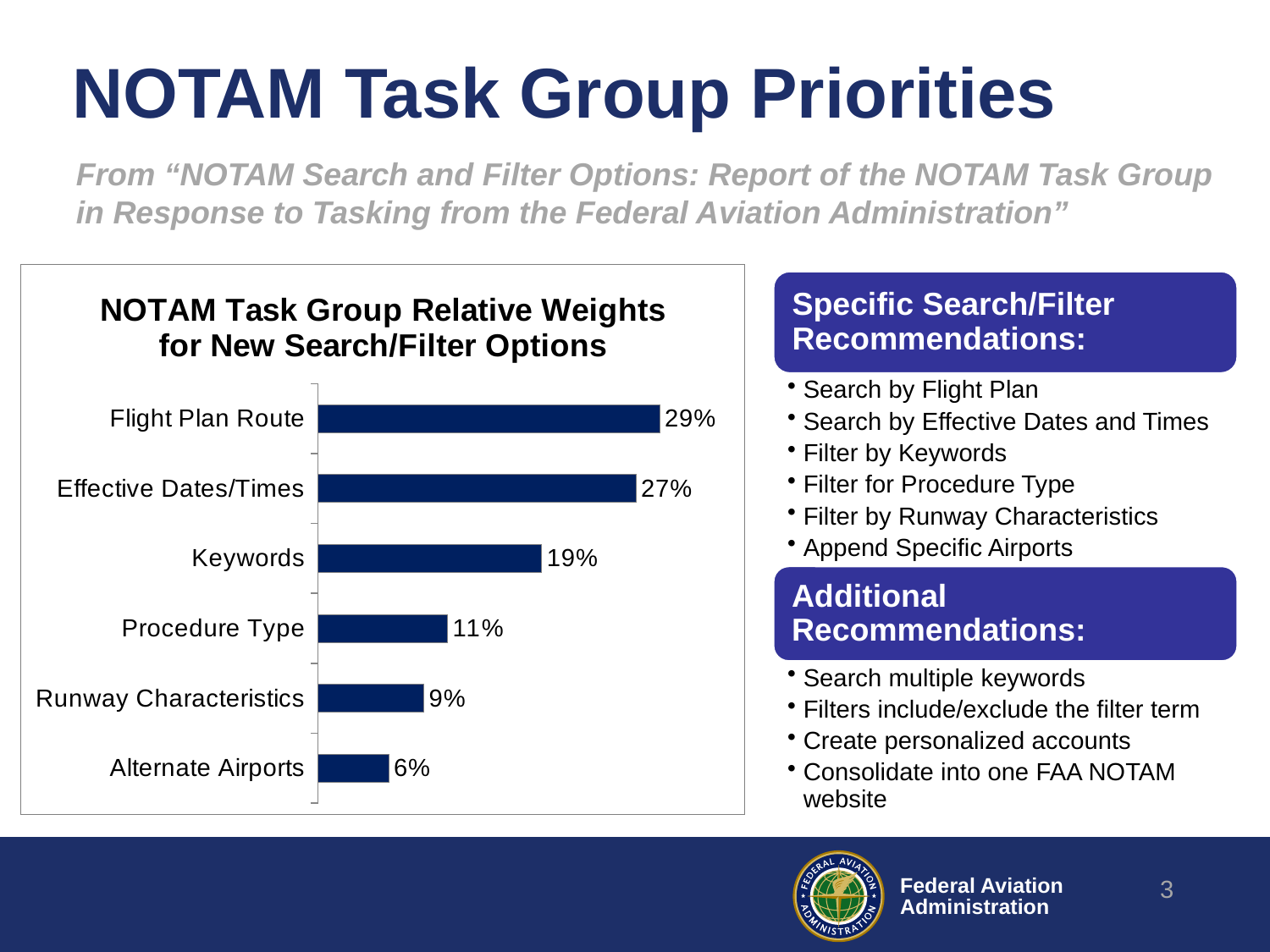
What is the relative weight for Flight Plan Route? 29% Which category has the highest relative weight? Flight Plan Route What is the difference between the relative weights for Flight Plan Route and Effective Dates/Times? 2% What is the relative weight for Runway Characteristics? 9% What is the difference between the relative weights for Keywords and Procedure Type? 8% What is the title of the chart? NOTAM Task Group Relative Weights for New Search/Filter Options What is the relative weight for Keywords? 19% What is the relative weight for Alternate Airports? 6% Which category has the lowest relative weight? Alternate Airports What kind of chart is shown on the slide? Bar chart How many categories are shown in the chart? 6 Which has a larger relative weight, Procedure Type or Runway Characteristics? Procedure Type